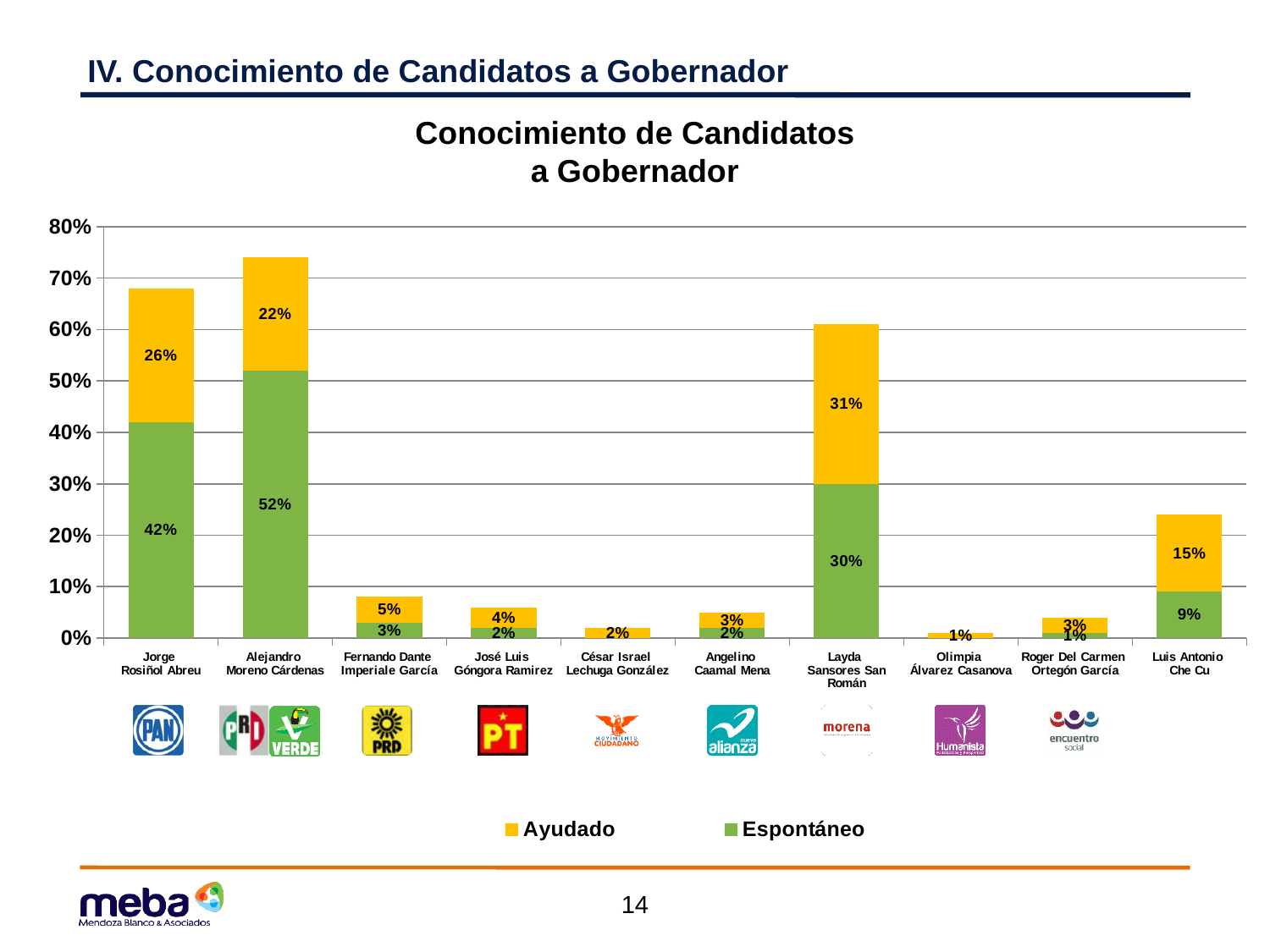
What kind of chart is shown on the slide? Stacked bar chart What is the Ayudado value for Layda Sansores San Román? 31% Which candidate has the highest Espontáneo value? Alejandro Moreno Cárdenas What is the Espontáneo value for Jorge Rosiñol Abreu? 42% What is the Ayudado value for Luis Antonio Che Cu? 15% Which candidate has the highest Ayudado value? Layda Sansores San Román Which is larger: the Ayudado value for Jorge Rosiñol Abreu or the Ayudado value for Alejandro Moreno Cárdenas? Jorge Rosiñol Abreu How many candidates are shown on the x axis? 10 What is the total of the stacked bar for Luis Antonio Che Cu? 24% Is the total stacked bar for Layda Sansores San Román greater or less than 50%? greater How many series does the legend list? 2 What is the difference between the Espontáneo values of Alejandro Moreno Cárdenas and Jorge Rosiñol Abreu? 10%